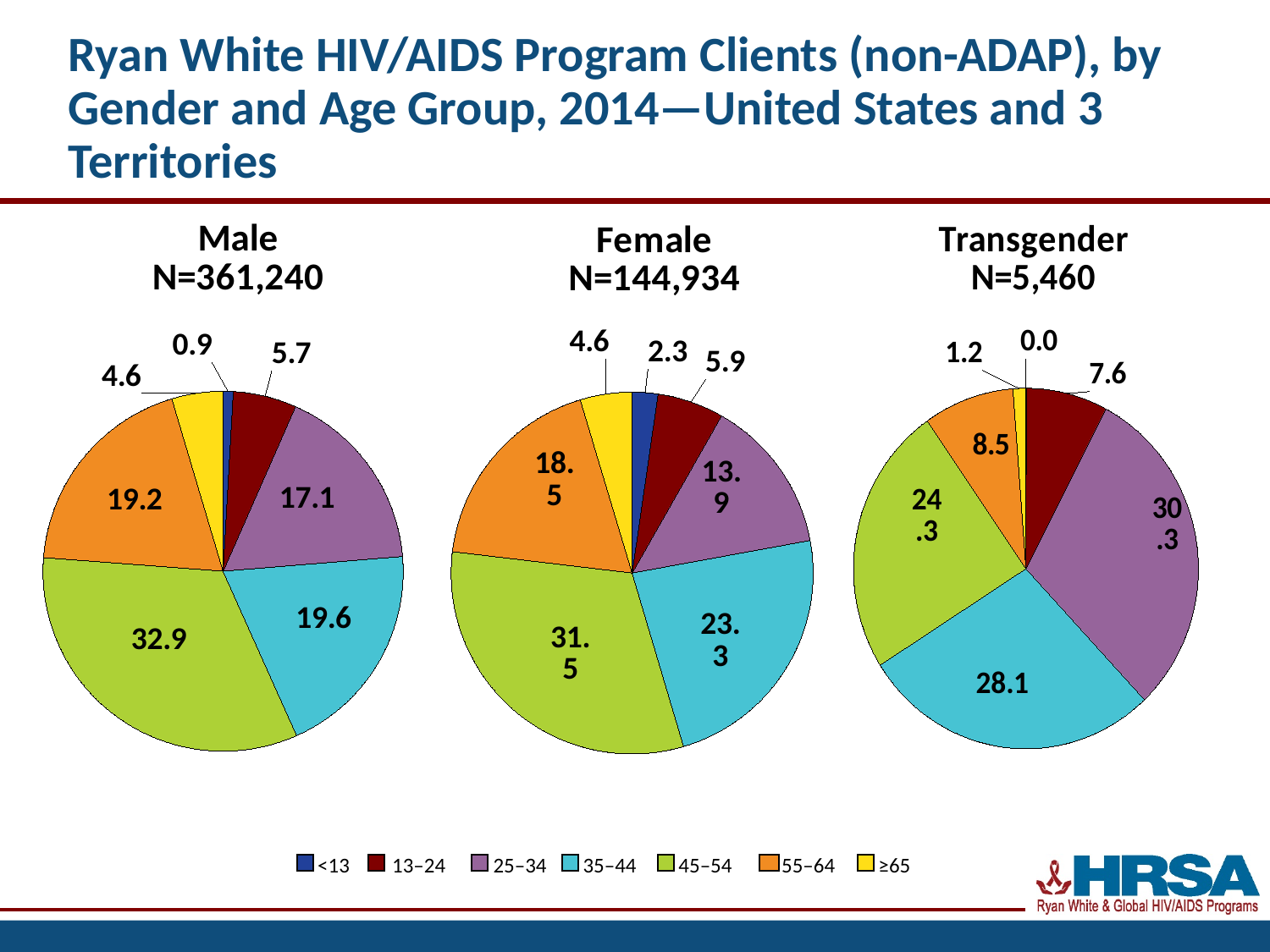
In the Transgender pie chart, what is the value for the 25–34 age group? 30.3 In the Male pie chart, what is the value for the 45–54 age group? 32.9 How many age groups does the legend list? 7 In the Male pie chart, what is the difference between the values for 35–44 and 55–64? 0.4 In the Male pie chart, which age group has the largest share? 45–54 In the Female pie chart, what is the value for the 35–44 age group? 23.3 What is the N value shown for the Female pie chart? N=144,934 In the Female pie chart, what is the difference between the values for 45–54 and 25–34? 17.6 In the Transgender pie chart, which age group has the smallest share? <13 What kind of charts are shown on the slide? Pie charts In the Transgender pie chart, which is larger: the value for 25–34 or the value for 35–44? 25–34 In the Female pie chart, which age group has the smallest share? <13